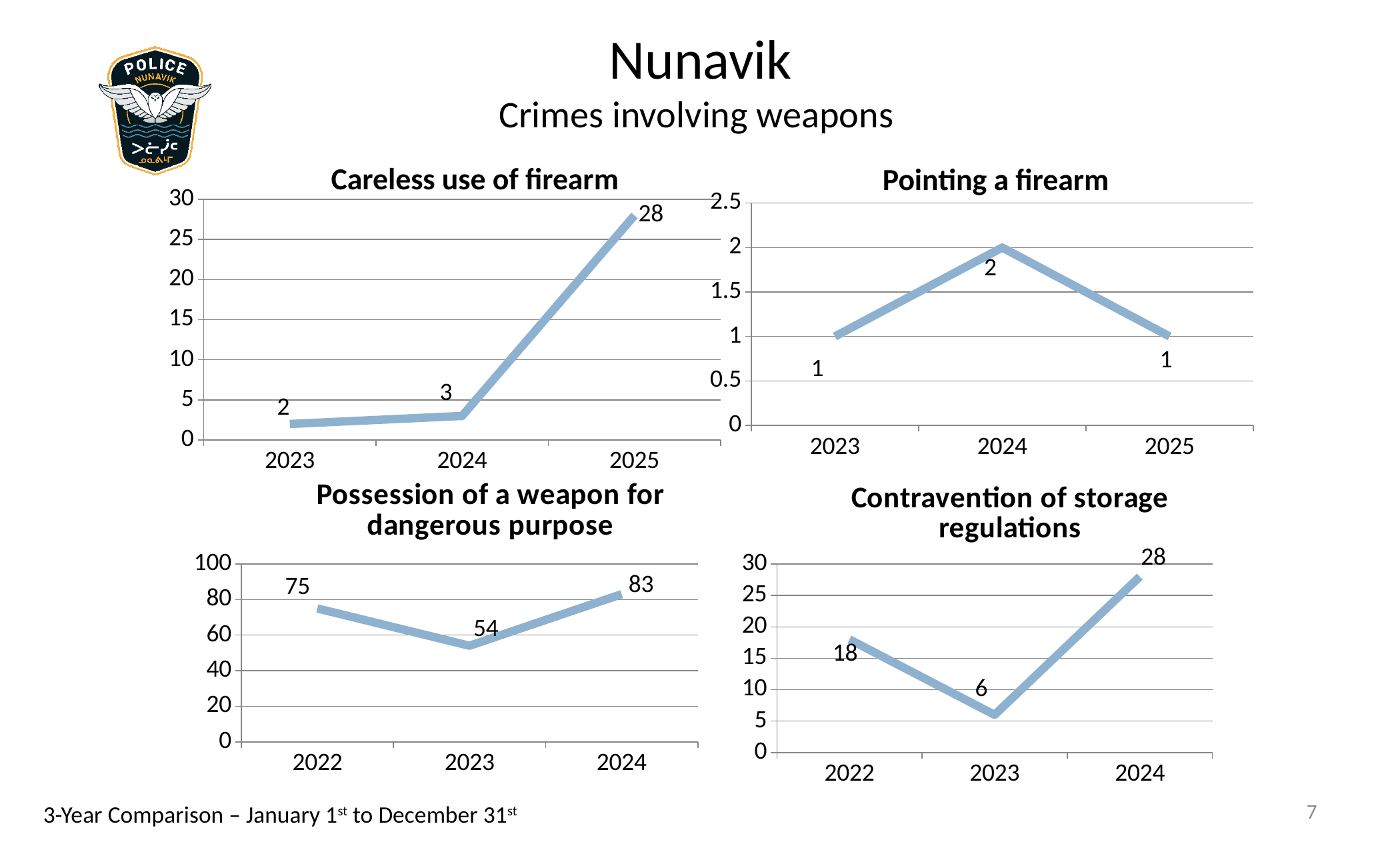
In the 'Pointing a firearm' chart, which year has the highest value? 2024 How many data points are plotted in the 'Careless use of firearm' chart? 3 In the 'Pointing a firearm' chart, what is the value for 2023? 1 In the 'Possession of a weapon for dangerous purpose' chart, what is the value for 2024? 83 What kind of chart is the 'Pointing a firearm' chart? line chart In the 'Possession of a weapon for dangerous purpose' chart, which year has the lowest value? 2023 In the 'Contravention of storage regulations' chart, what is the difference between the 2024 and 2022 values? 10 In the 'Contravention of storage regulations' chart, what is the value for 2023? 6 In the 'Careless use of firearm' chart, what is the value for 2025? 28 In the 'Careless use of firearm' chart, do the values rise or fall from 2023 to 2025? rise In the 'Careless use of firearm' chart, what is the difference between the 2025 and 2024 values? 25 In the 'Possession of a weapon for dangerous purpose' chart, is the value for 2022 larger or smaller than the value for 2024? smaller